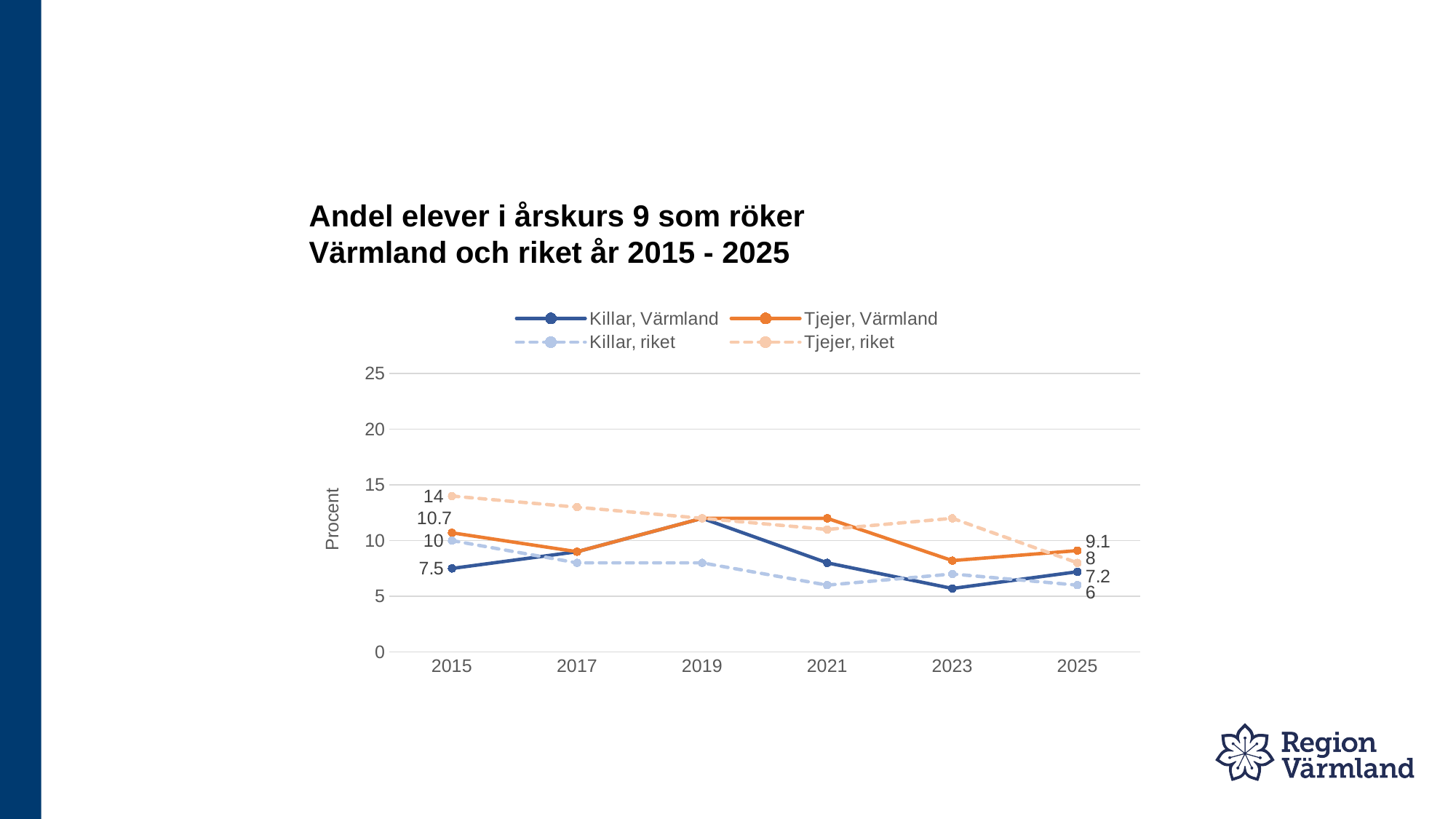
What is the difference between Tjejer, Värmland and Killar, Värmland in 2025? 1.9 Is the value for Killar, Värmland in 2023 greater or less than 10? less What is the difference between Tjejer, riket and Killar, riket in 2015? 4 What kind of chart is shown on the slide? line chart Which series has the highest value in 2015? Tjejer, riket What is the value for Killar, riket in 2025? 6 What is the value for Killar, Värmland in 2015? 7.5 How many years are shown on the x axis? 6 What is the value for Tjejer, riket in 2015? 14 What is the value for Tjejer, Värmland in 2025? 9.1 Does the value for Tjejer, riket rise or fall from 2015 to 2025? fall How many series does the legend list? 4